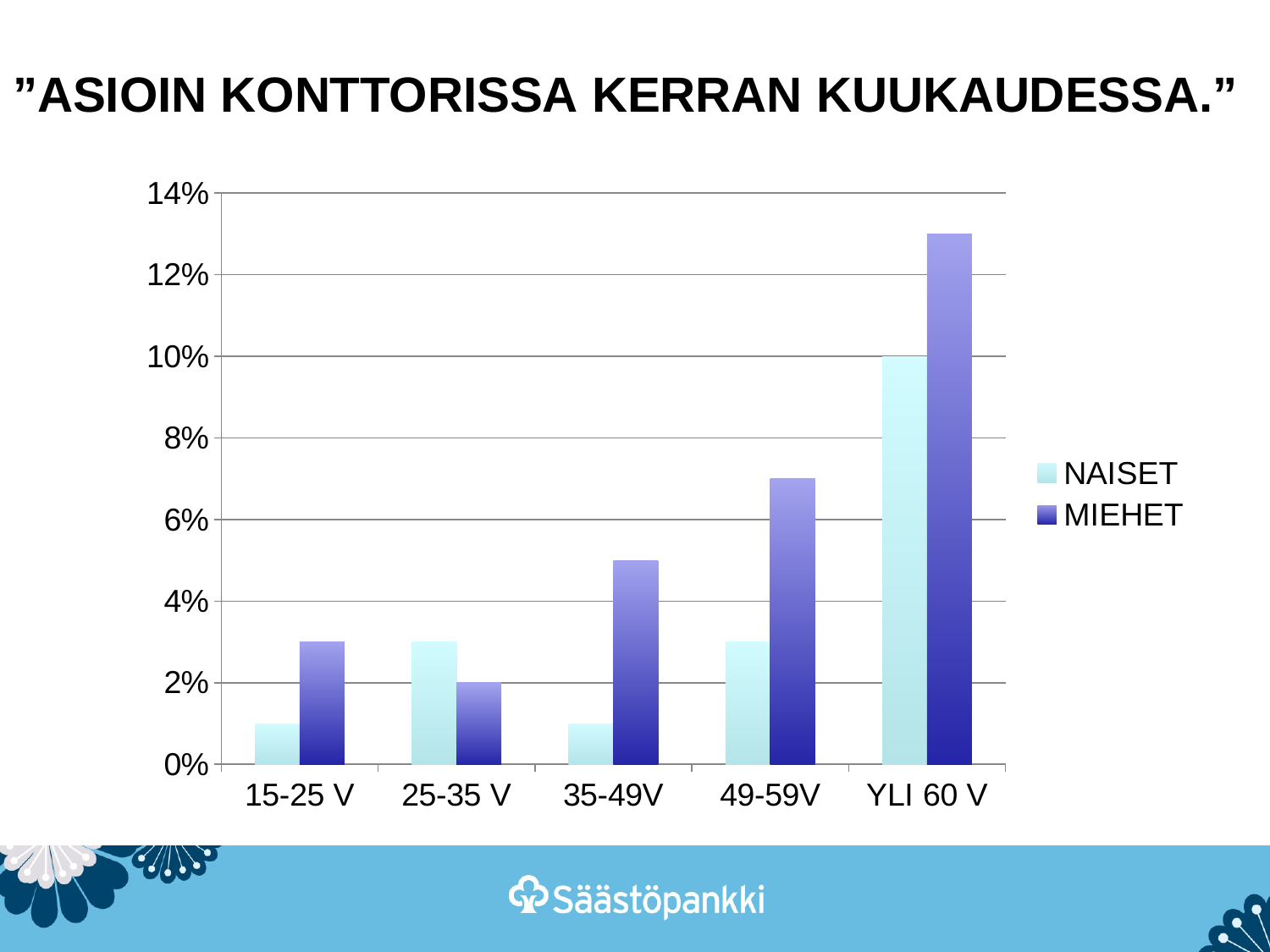
What is the MIEHET value for 25-35 V? 2% Is the NAISET value for 35-49V greater or less than 2%? less Which age group has the lowest MIEHET value? 25-35 V Is the MIEHET value for YLI 60 V greater or less than 12%? greater How many series does the legend list? 2 How many age groups are shown on the x axis? 5 For 15-25 V, which series has the larger value, NAISET or MIEHET? MIEHET Which age group has the highest NAISET value? YLI 60 V For 25-35 V, which series has the larger value, NAISET or MIEHET? NAISET What is the NAISET value for YLI 60 V? 10% Which age group has the highest MIEHET value? YLI 60 V What kind of chart is shown on the slide? bar chart